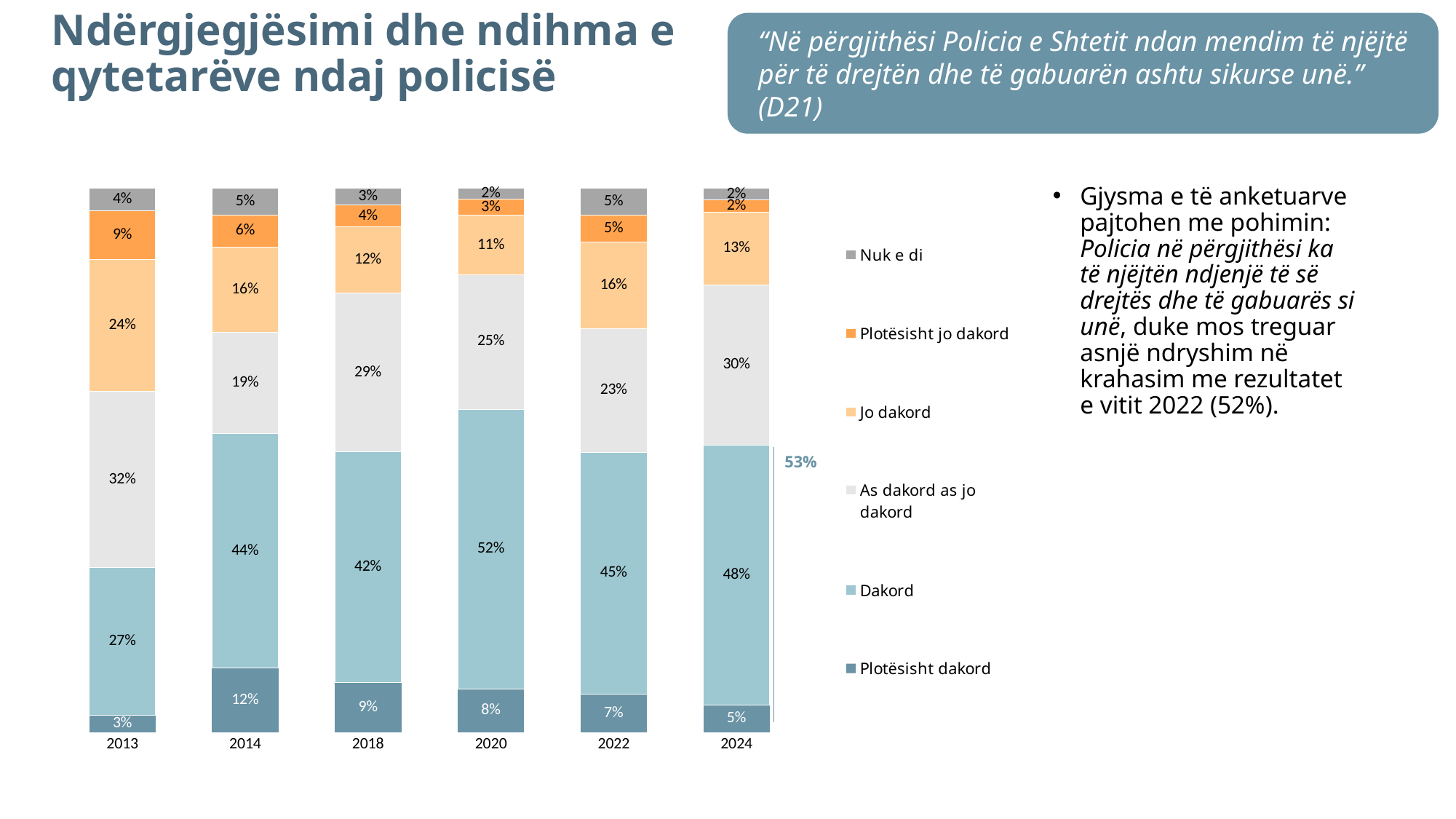
In which year is the "Plotësisht dakord" value lowest? 2013 What is the combined total of "Plotësisht dakord" and "Dakord" in 2024? 53% What is the value for "Jo dakord" in 2013? 24% Which is larger: the "Jo dakord" value in 2014 or in 2018? 2014 What is the value for "Plotësisht dakord" in 2014? 12% In which year is the "Dakord" value highest? 2020 What is the value for "As dakord as jo dakord" in 2024? 30% What is the difference between the "Dakord" values for 2024 and 2022? 3% What is the value for "Dakord" in 2020? 52% How many years are shown on the x axis of the chart? 6 How many series does the chart legend list? 6 What kind of chart is shown on the slide? Stacked bar chart